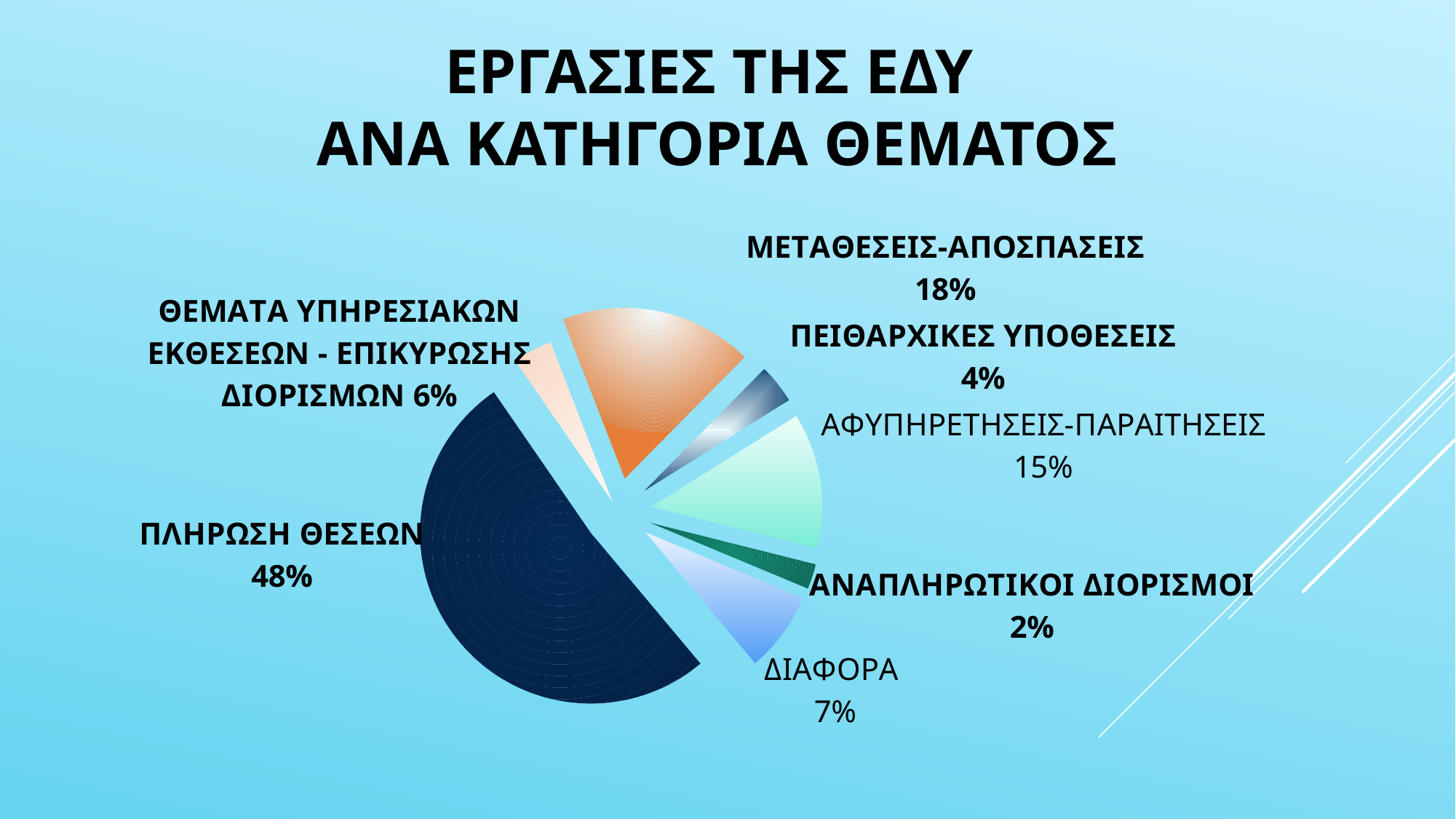
Which category has the largest share of the pie? ΠΛΗΡΩΣΗ ΘΕΣΕΩΝ What is the value for ΜΕΤΑΘΕΣΕΙΣ-ΑΠΟΣΠΑΣΕΙΣ? 18% What kind of chart is shown on the slide? pie chart Which is larger, ΔΙΑΦΟΡΑ or ΘΕΜΑΤΑ ΥΠΗΡΕΣΙΑΚΩΝ ΕΚΘΕΣΕΩΝ - ΕΠΙΚΥΡΩΣΗΣ ΔΙΟΡΙΣΜΩΝ? ΔΙΑΦΟΡΑ What is the title of the chart? ΕΡΓΑΣΙΕΣ ΤΗΣ ΕΔΥ ΑΝΑ ΚΑΤΗΓΟΡΙΑ ΘΕΜΑΤΟΣ What is the value for ΔΙΑΦΟΡΑ? 7% What is the value for ΠΕΙΘΑΡΧΙΚΕΣ ΥΠΟΘΕΣΕΙΣ? 4% How many slices does the pie chart have? 7 What is the difference in percentage points between ΜΕΤΑΘΕΣΕΙΣ-ΑΠΟΣΠΑΣΕΙΣ and ΑΦΥΠΗΡΕΤΗΣΕΙΣ-ΠΑΡΑΙΤΗΣΕΙΣ? 3% What share of the pie is ΠΛΗΡΩΣΗ ΘΕΣΕΩΝ? 48% Which category has the smallest share of the pie? ΑΝΑΠΛΗΡΩΤΙΚΟΙ ΔΙΟΡΙΣΜΟΙ What is the value for ΑΦΥΠΗΡΕΤΗΣΕΙΣ-ΠΑΡΑΙΤΗΣΕΙΣ? 15%